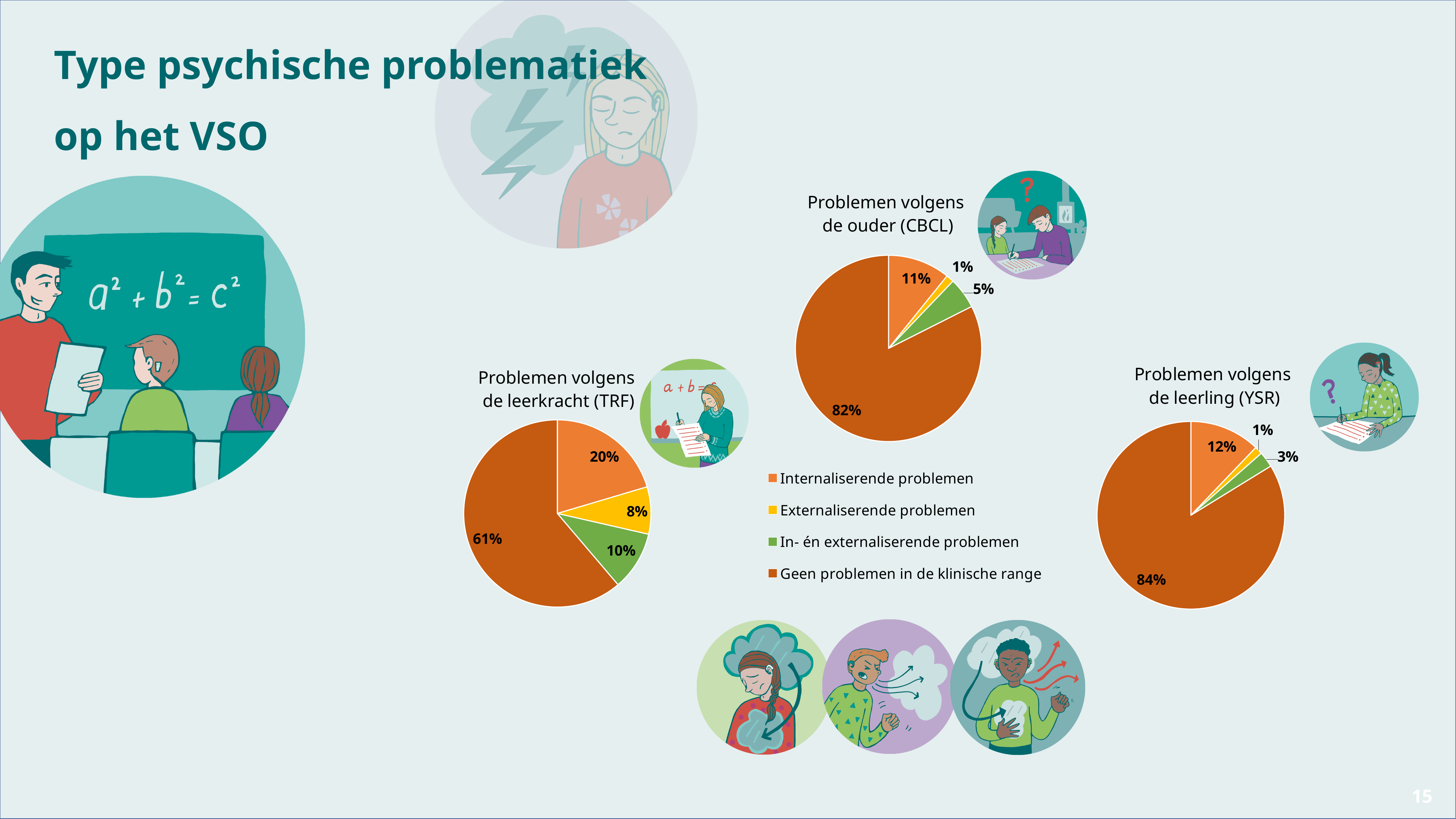
Which chart shows a larger share for 'Geen problemen in de klinische range': the CBCL chart or the YSR chart? YSR chart In the 'Problemen volgens de ouder (CBCL)' chart, what share is 'In- én externaliserende problemen'? 5% In the 'Problemen volgens de leerkracht (TRF)' chart, which category has the largest slice? Geen problemen in de klinische range In the 'Problemen volgens de leerling (YSR)' chart, what share is 'Internaliserende problemen'? 12% In the 'Problemen volgens de leerkracht (TRF)' chart, what share is 'Internaliserende problemen'? 20% In the 'Problemen volgens de leerling (YSR)' chart, what share is 'In- én externaliserende problemen'? 3% In the 'Problemen volgens de leerkracht (TRF)' chart, what is the difference between 'Internaliserende problemen' and 'Externaliserende problemen'? 12% How many pie charts are shown on the slide? 3 In the 'Problemen volgens de leerkracht (TRF)' chart, what share is 'Geen problemen in de klinische range'? 61% What type of chart is 'Problemen volgens de ouder (CBCL)'? Pie chart How many categories does the shared legend list? 4 In the 'Problemen volgens de ouder (CBCL)' chart, which category has the smallest slice? Externaliserende problemen